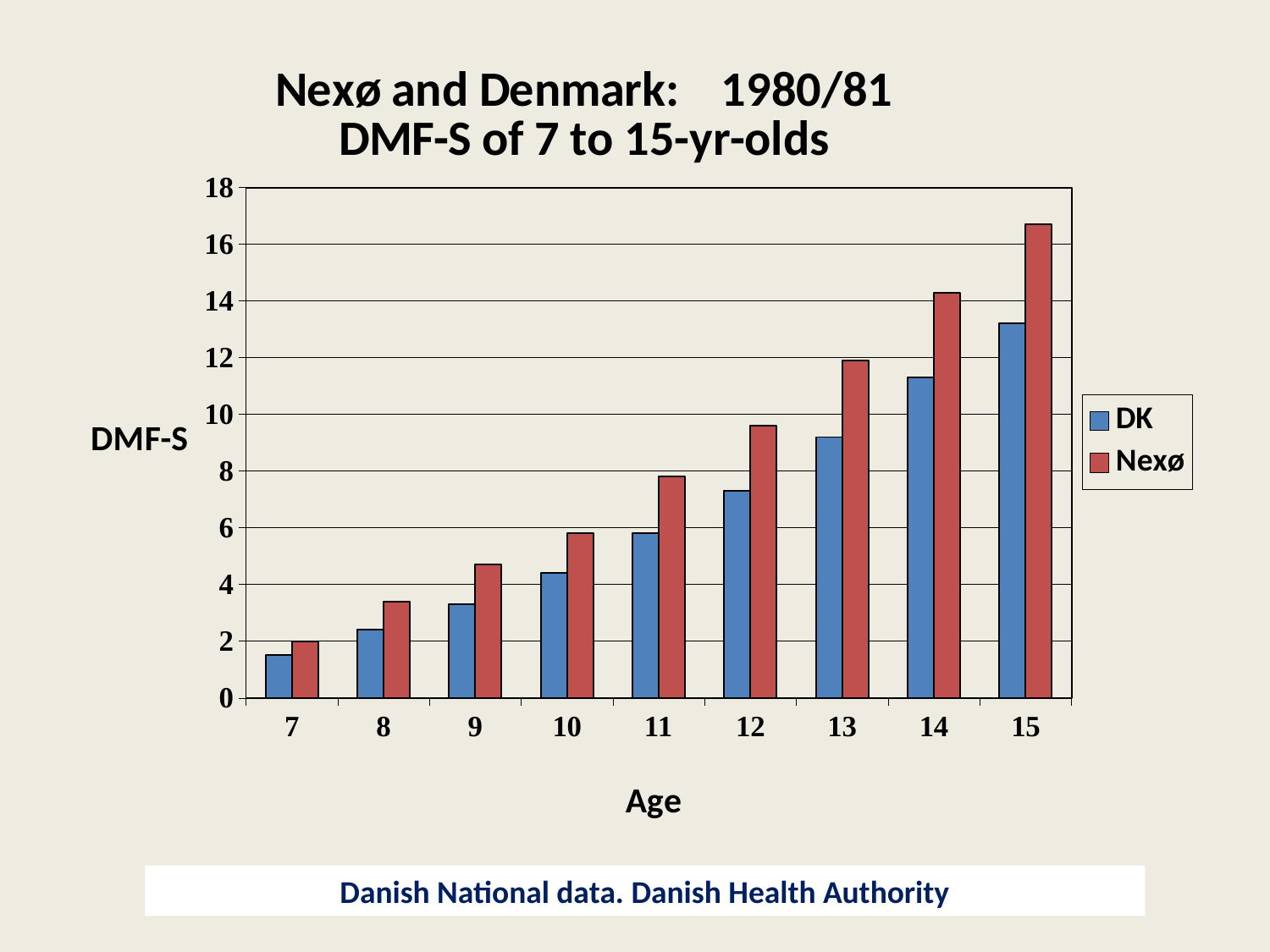
Which age has the highest DMF-S value for Nexø? 15 Do the DMF-S values for Nexø rise or fall as age increases from 7 to 15? rise Is the DK value at age 12 greater or less than 8? less Is the DK value at age 15 greater or less than 12? greater How many age categories are shown on the x axis? 9 What is the label of the y axis? DMF-S How many series does the legend list? 2 Is the Nexø value at age 15 greater or less than 16? greater Which age has the lowest DMF-S value for DK? 7 At age 15, which series has the larger DMF-S value, DK or Nexø? Nexø What kind of chart is shown on the slide? bar chart